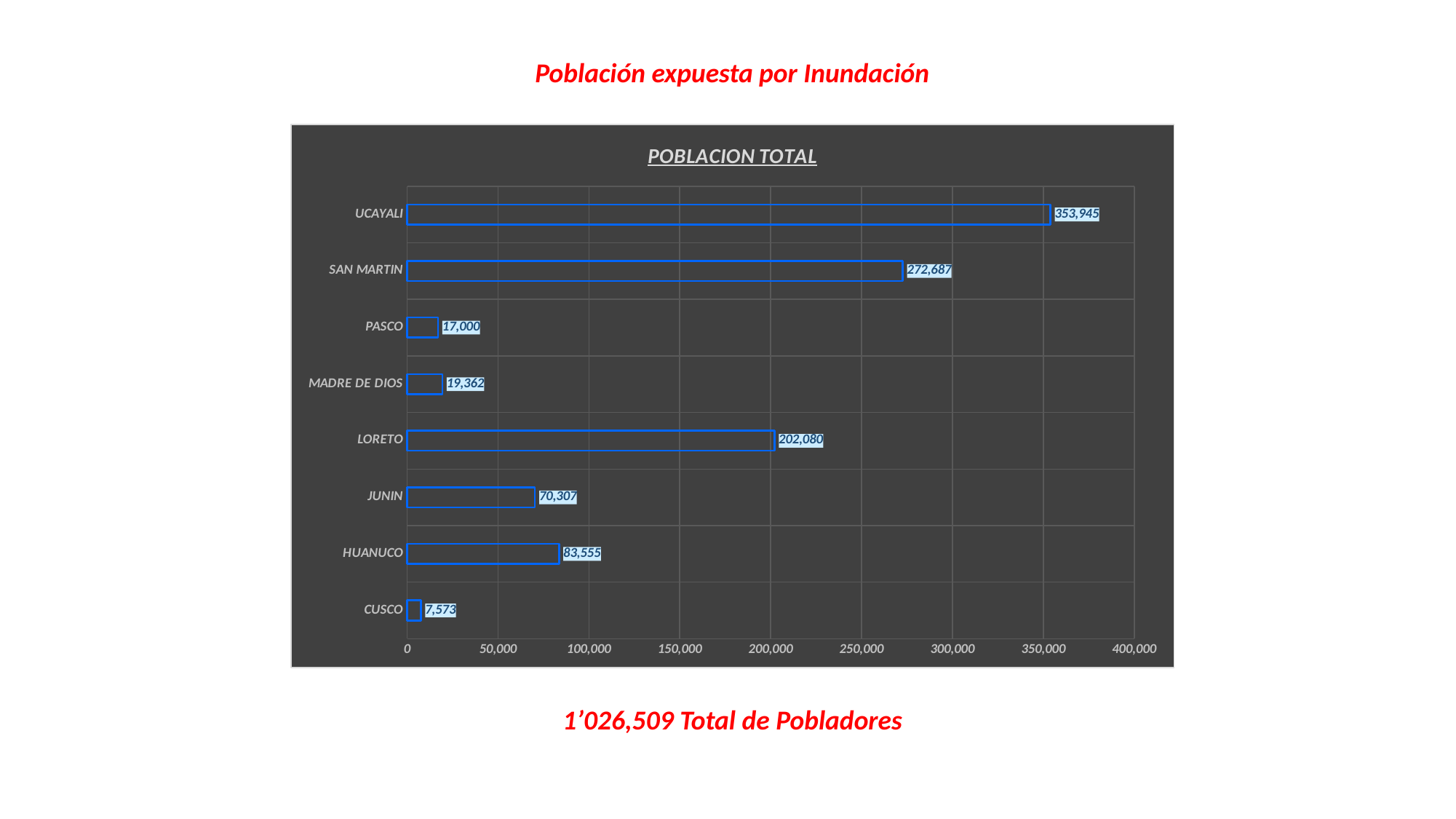
What is the value for MADRE DE DIOS? 19,362 What is the difference between the values for PASCO and CUSCO? 9,427 What is the title of the chart? POBLACION TOTAL How many categories are shown in the chart? 8 What kind of chart is shown on the slide? bar chart What is the difference between the values for UCAYALI and SAN MARTIN? 81,258 Which category has the highest value? UCAYALI What is the value for UCAYALI? 353,945 Is the value for LORETO greater or less than 250,000? less Which is larger, the value for HUANUCO or the value for JUNIN? HUANUCO What is the value for LORETO? 202,080 Which category has the lowest value? CUSCO